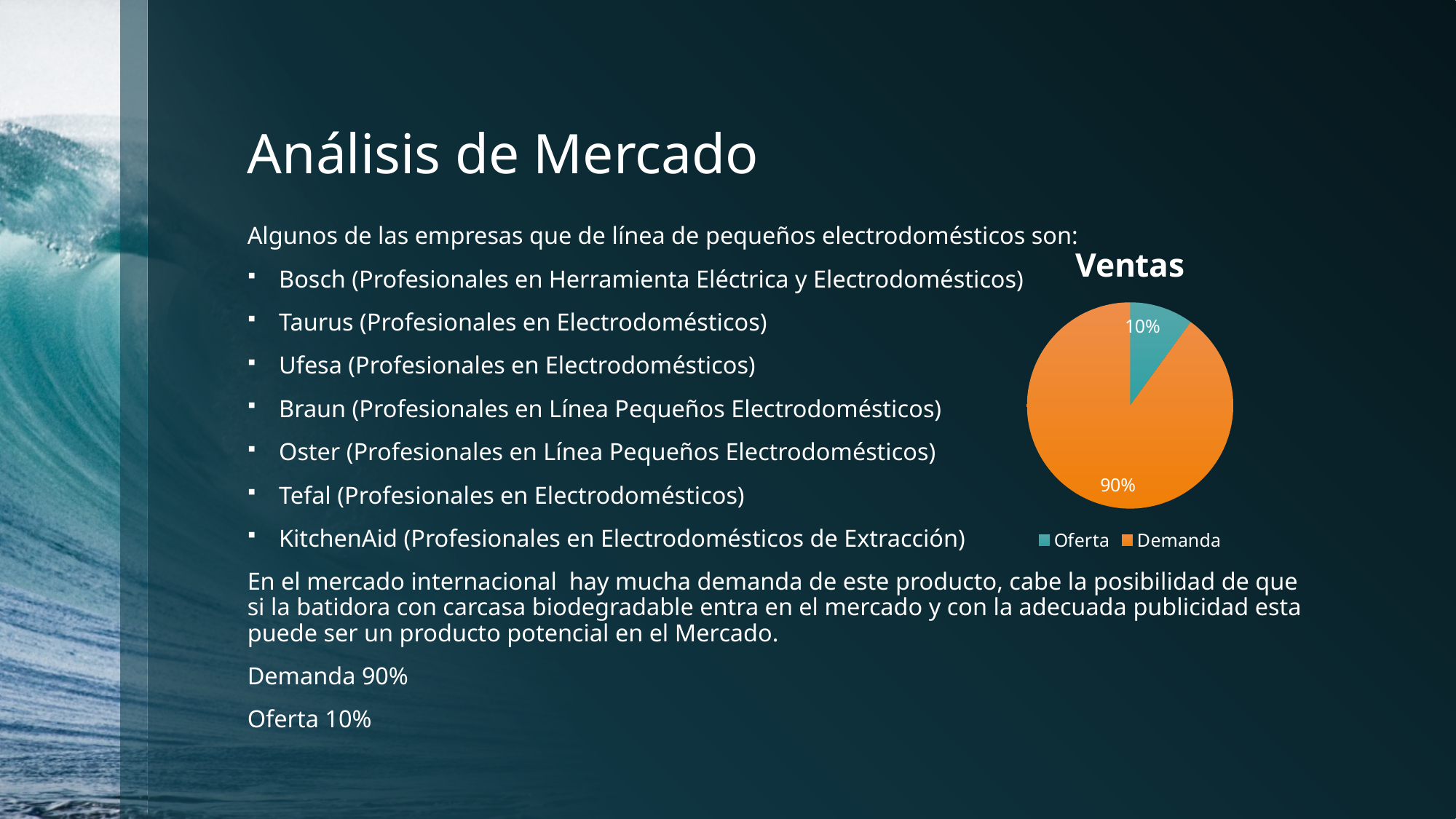
What is the difference in percentage points between the Demanda and Oferta slices? 80 What colour is the Demanda slice? orange How many entries does the legend list? 2 What share of the pie does Demanda have? 90% What share of the pie does Oferta have? 10% What is the title of the chart? Ventas What kind of chart is shown on the slide? pie chart Which slice of the pie is the largest? Demanda Which is larger, the Oferta slice or the Demanda slice? Demanda How many slices does the pie chart have? 2 Which slice of the pie is the smallest? Oferta